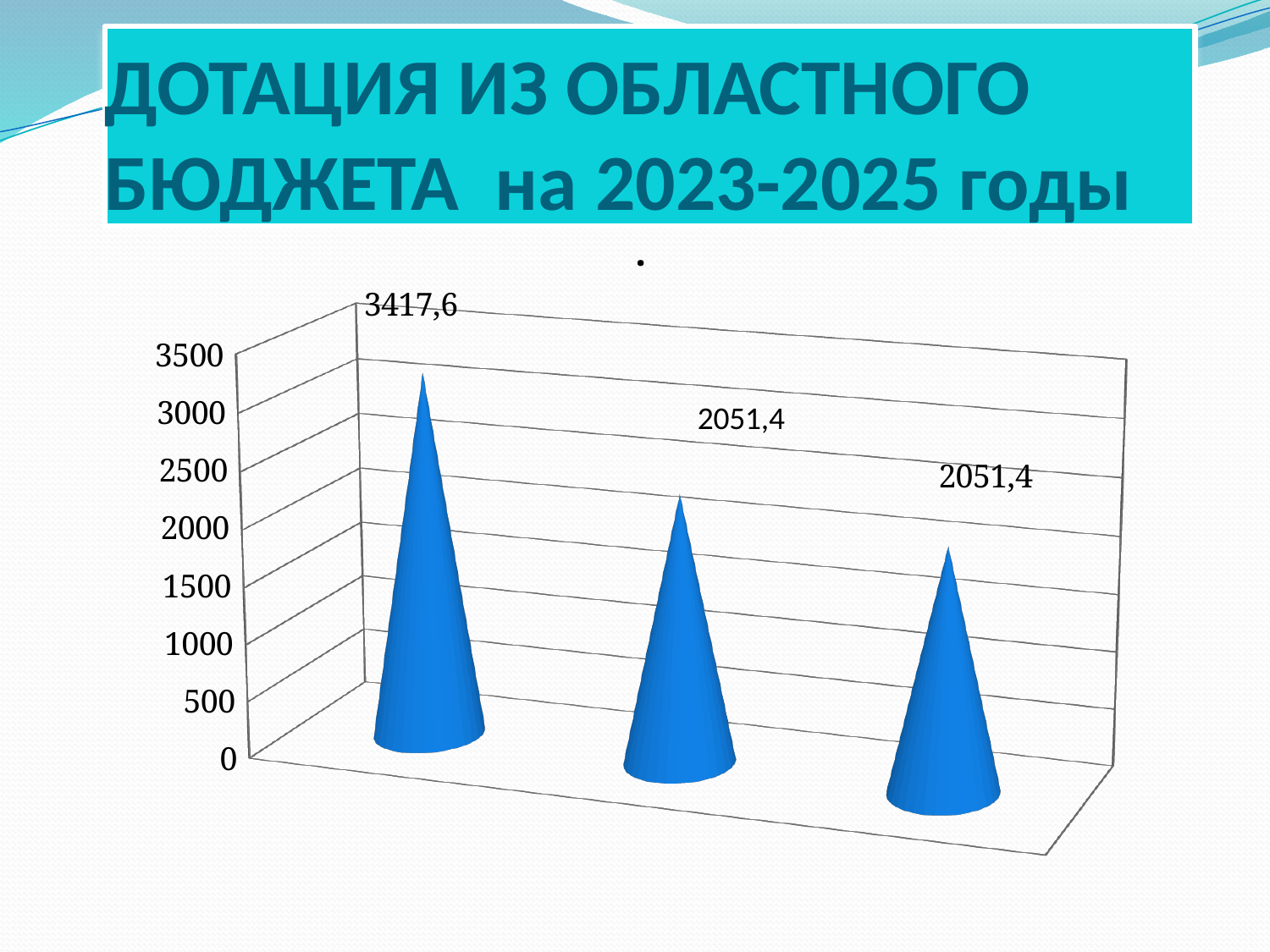
Which is larger, the value of the leftmost bar or the value of the middle bar? the leftmost bar What is the highest value labelled on the vertical axis? 3500 Is the value for the leftmost bar greater or less than 3000? greater How many bars are plotted on the chart? 3 What is the difference between the leftmost bar's value and the middle bar's value? 1366,2 What kind of chart is shown on the slide? bar chart Do the values rise or fall from the leftmost bar to the rightmost bar? fall What is the value shown for the leftmost bar? 3417,6 Which bar has the highest value? the leftmost bar What is the value shown for the rightmost bar? 2051,4 Which is larger, the value of the middle bar or the value of the rightmost bar? they are equal What is the value shown for the middle bar? 2051,4